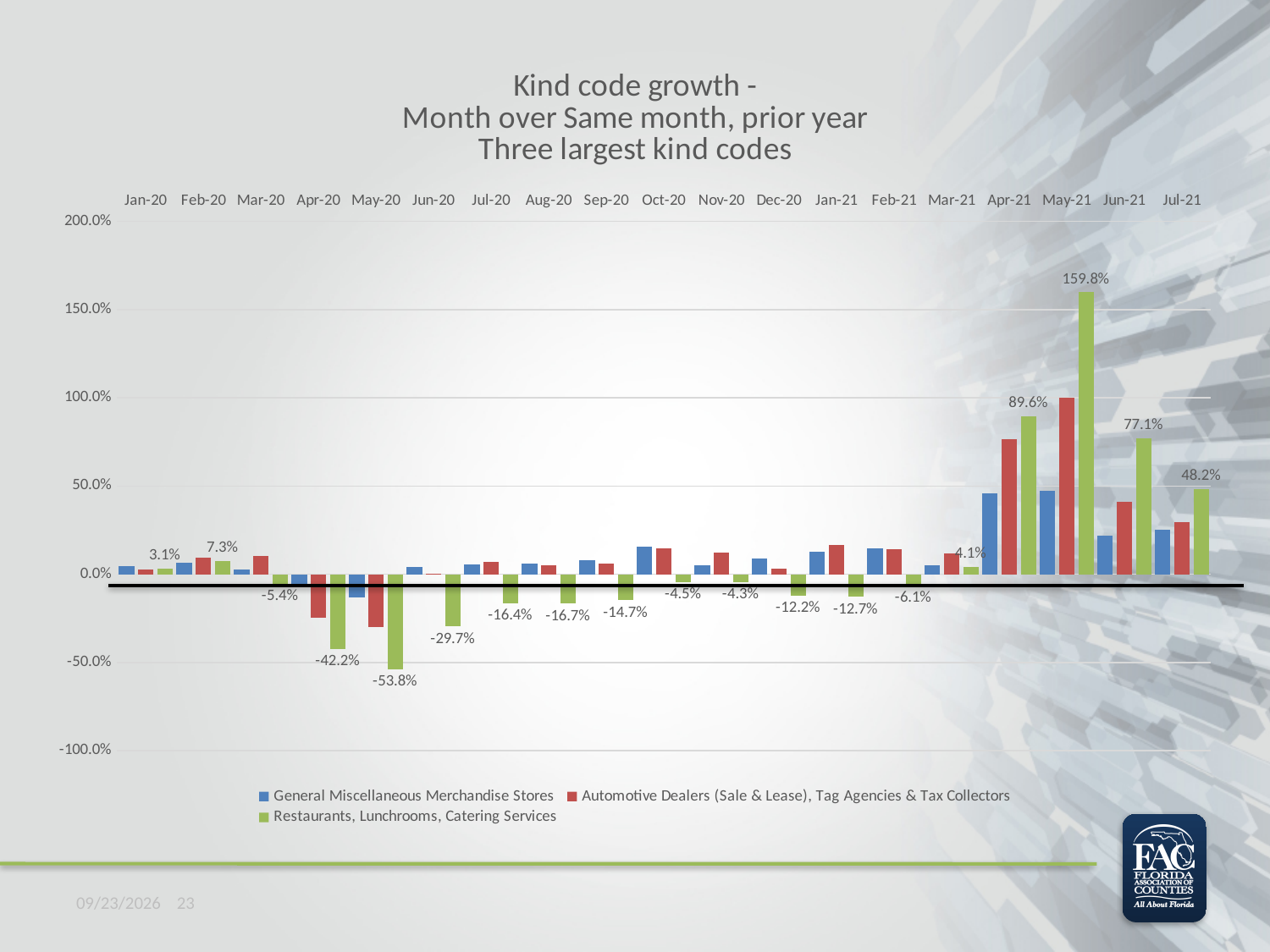
How many series does the legend list? 3 What is the value for Restaurants, Lunchrooms, Catering Services in May-20? -53.8% Which is larger for Restaurants, Lunchrooms, Catering Services: the Apr-20 value or the Jun-20 value? Jun-20 In which month is the Restaurants, Lunchrooms, Catering Services value lowest? May-20 Is the value for Automotive Dealers (Sale & Lease), Tag Agencies & Tax Collectors in May-21 greater or less than 50.0%? greater What is the value for Restaurants, Lunchrooms, Catering Services in May-21? 159.8% How many months are shown on the x axis? 19 In which month is the Restaurants, Lunchrooms, Catering Services value highest? May-21 What is the difference between the Restaurants, Lunchrooms, Catering Services values in May-21 and Jun-21? 82.7% What is the title of the chart? Kind code growth - Month over Same month, prior year Three largest kind codes What type of chart is shown on the slide? bar chart What is the value for Restaurants, Lunchrooms, Catering Services in Apr-21? 89.6%